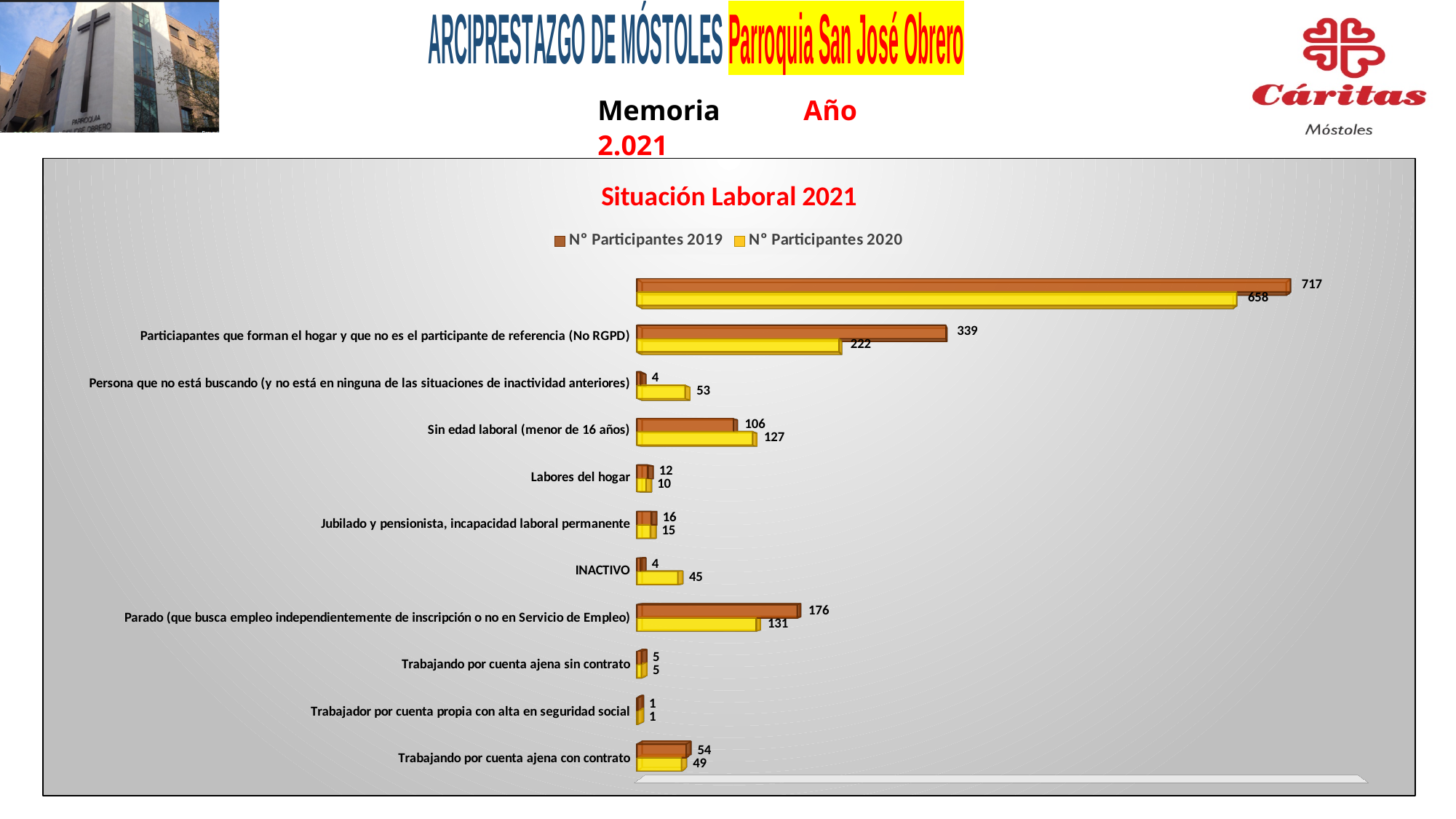
What is the title of the chart? Situación Laboral 2021 How many series does the legend of the 'Situación Laboral 2021' chart list? 2 What is the difference between the 2019 and 2020 values for 'Trabajando por cuenta ajena con contrato'? 5 What is the largest N° Participantes 2019 value shown in the chart? 717 Which is larger for 'Sin edad laboral (menor de 16 años)': the N° Participantes 2019 value or the N° Participantes 2020 value? N° Participantes 2020 What is the N° Participantes 2019 value for 'Sin edad laboral (menor de 16 años)'? 106 Which labeled category has the lowest N° Participantes 2020 value? Trabajador por cuenta propia con alta en seguridad social What is the N° Participantes 2020 value for 'INACTIVO'? 45 What is the difference between the 2019 and 2020 values for 'Persona que no está buscando (y no está en ninguna de las situaciones de inactividad anteriores)'? 49 What type of chart is shown on the slide? Bar chart What is the N° Participantes 2019 value for 'Parado (que busca empleo independientemente de inscripción o no en Servicio de Empleo)'? 176 What is the N° Participantes 2020 value for 'Participantes que forman el hogar y que no es el participante de referencia (No RGPD)'? 222